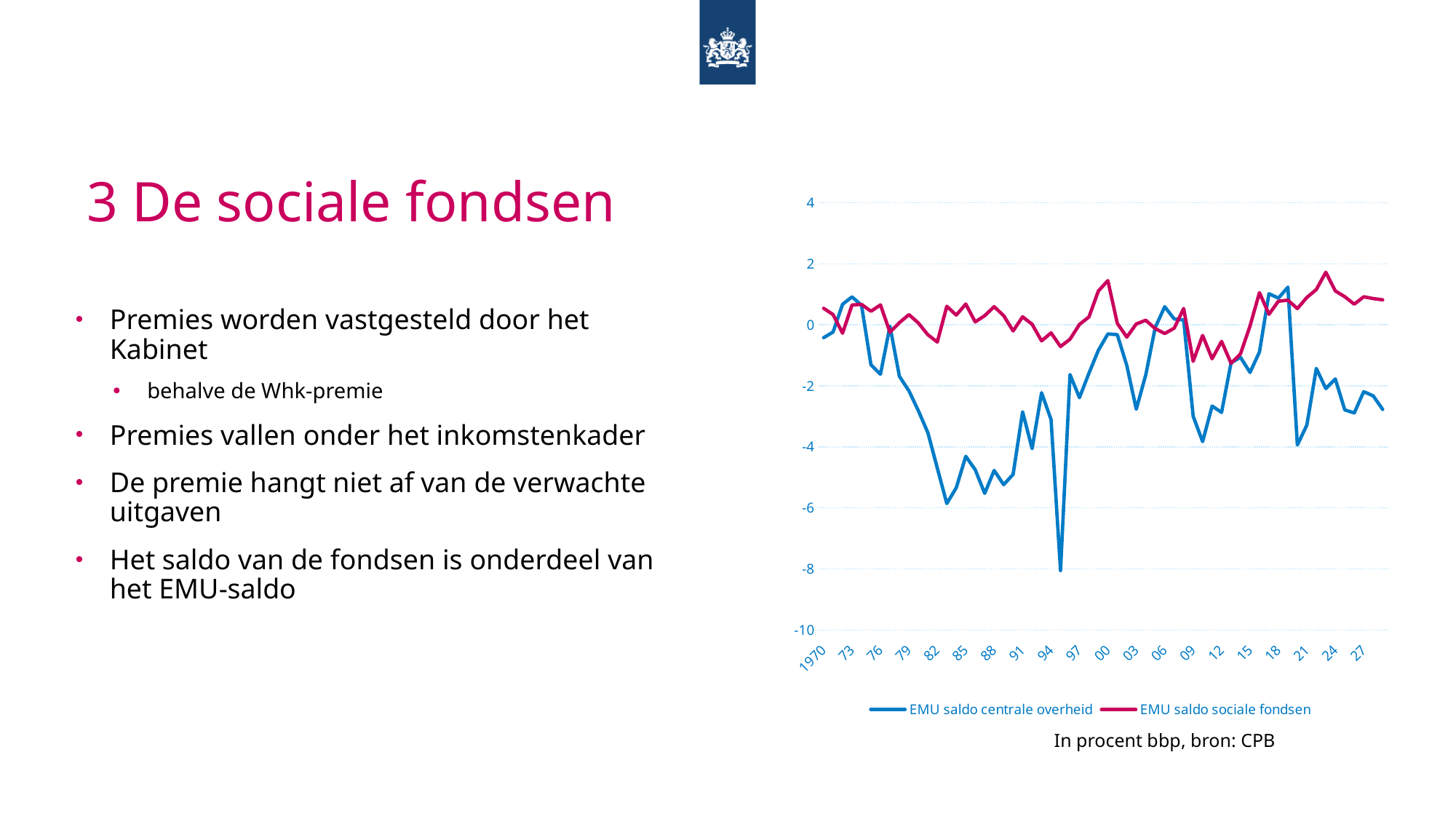
Between 1976 and 1983, does the EMU saldo centrale overheid line rise or fall? fall Is the value for EMU saldo centrale overheid in 1983 greater or less than -4? less In 2009, which series has the higher value, EMU saldo centrale overheid or EMU saldo sociale fondsen? EMU saldo sociale fondsen Which series reaches the lowest value anywhere on the chart? EMU saldo centrale overheid Does the EMU saldo sociale fondsen line ever fall below -2? No How many year labels are shown on the x axis of the chart? 20 What are the two series named in the chart legend? EMU saldo centrale overheid and EMU saldo sociale fondsen What kind of chart is shown on the slide? line chart How many series does the legend of the chart list? 2 What colour is the line for EMU saldo sociale fondsen? pink/red Is the value for EMU saldo sociale fondsen in 2024 greater or less than 0? greater